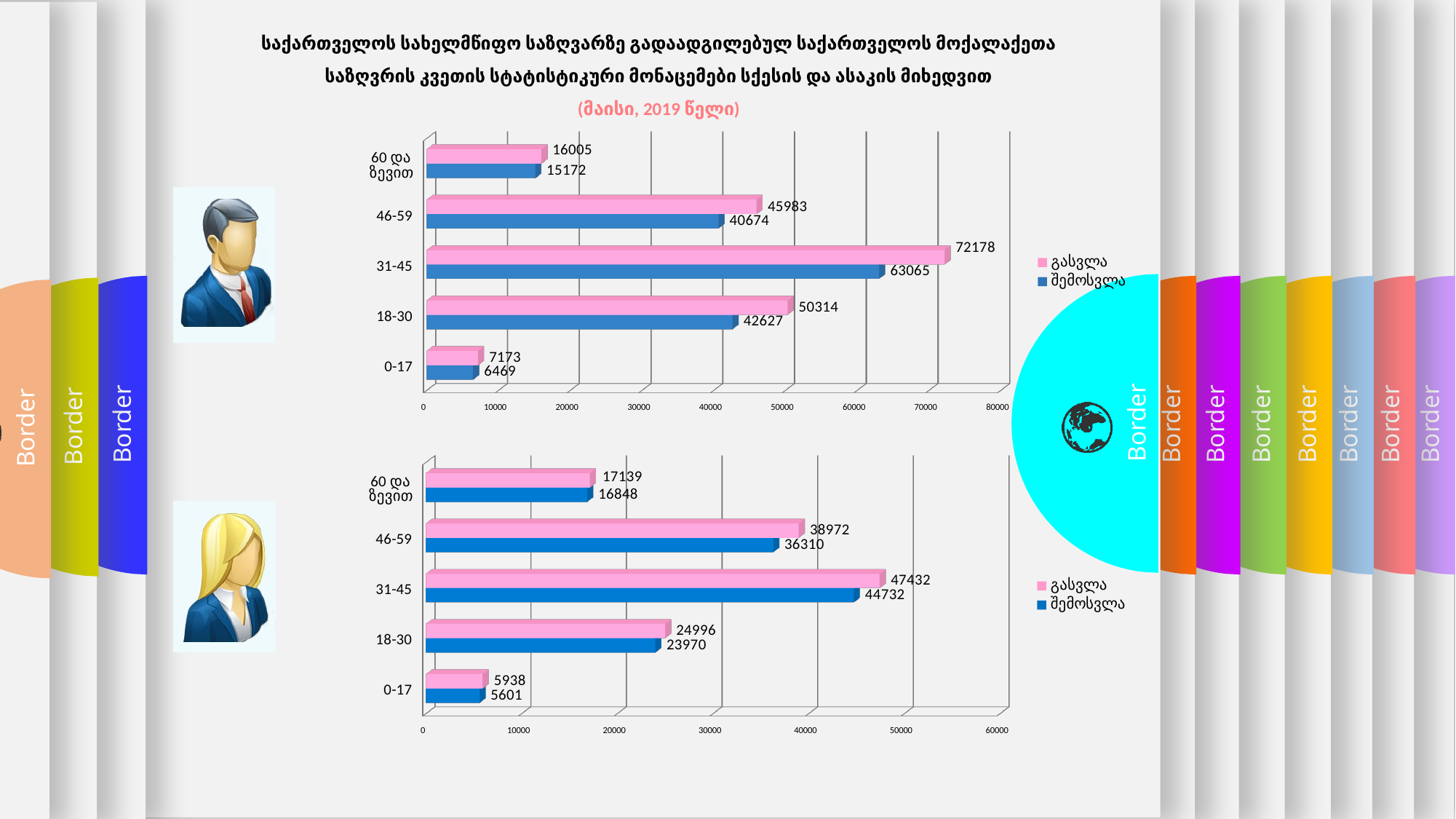
In the top chart, what is the value of the blue (შემოსვლა) bar for the 18-30 age group? 42627 In the bottom chart, which is larger: the გასვლა value for 18-30 or the გასვლა value for 60 და ზევით? 18-30 In the bottom chart, which age group has the lowest შემოსვლა value? 0-17 In the bottom chart, what is the value of the pink (გასვლა) bar for the 46-59 age group? 38972 In the bottom chart, what is the difference between the გასვლა and შემოსვლა values for the 31-45 age group? 2700 In the top chart, what is the difference between the გასვლა and შემოსვლა values for the 46-59 age group? 5309 How many age groups are shown in the top chart? 5 In the top chart, which age group has the highest გასვლა value? 31-45 How many series does the legend of the bottom chart list? 2 What type of chart is the top chart? Bar chart In the bottom chart, what is the value of the blue (შემოსვლა) bar for the 0-17 age group? 5601 In the top chart, what is the value of the pink (გასვლა) bar for the 31-45 age group? 72178